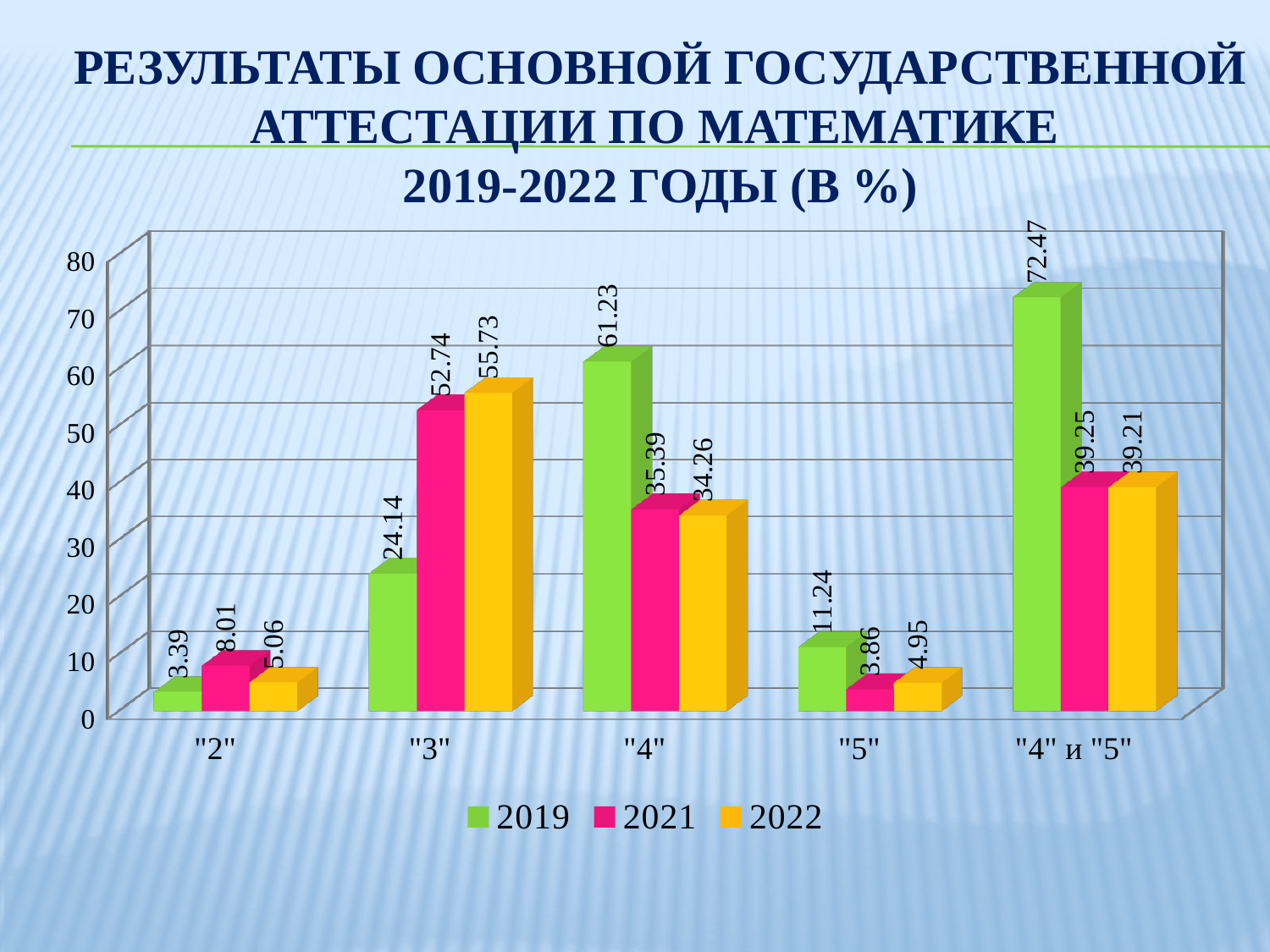
What is the value for 2021 in the "5" category? 3.86 Which years are listed in the legend? 2019, 2021, 2022 What is the value for 2022 in the "3" category? 55.73 Which is larger in the "3" category: the 2019 value or the 2021 value? 2021 How many series does the legend list? 3 Is the 2019 value for "4" и "5" greater or less than 70? greater What is the difference between the 2019 and 2021 values in the "4" category? 25.84 What kind of chart is shown on the slide? bar chart Which category has the lowest value for the 2021 series? "5" Which category has the highest value for the 2019 series? "4" и "5" How many categories are shown on the x axis? 5 What is the value for 2019 in the "4" category? 61.23